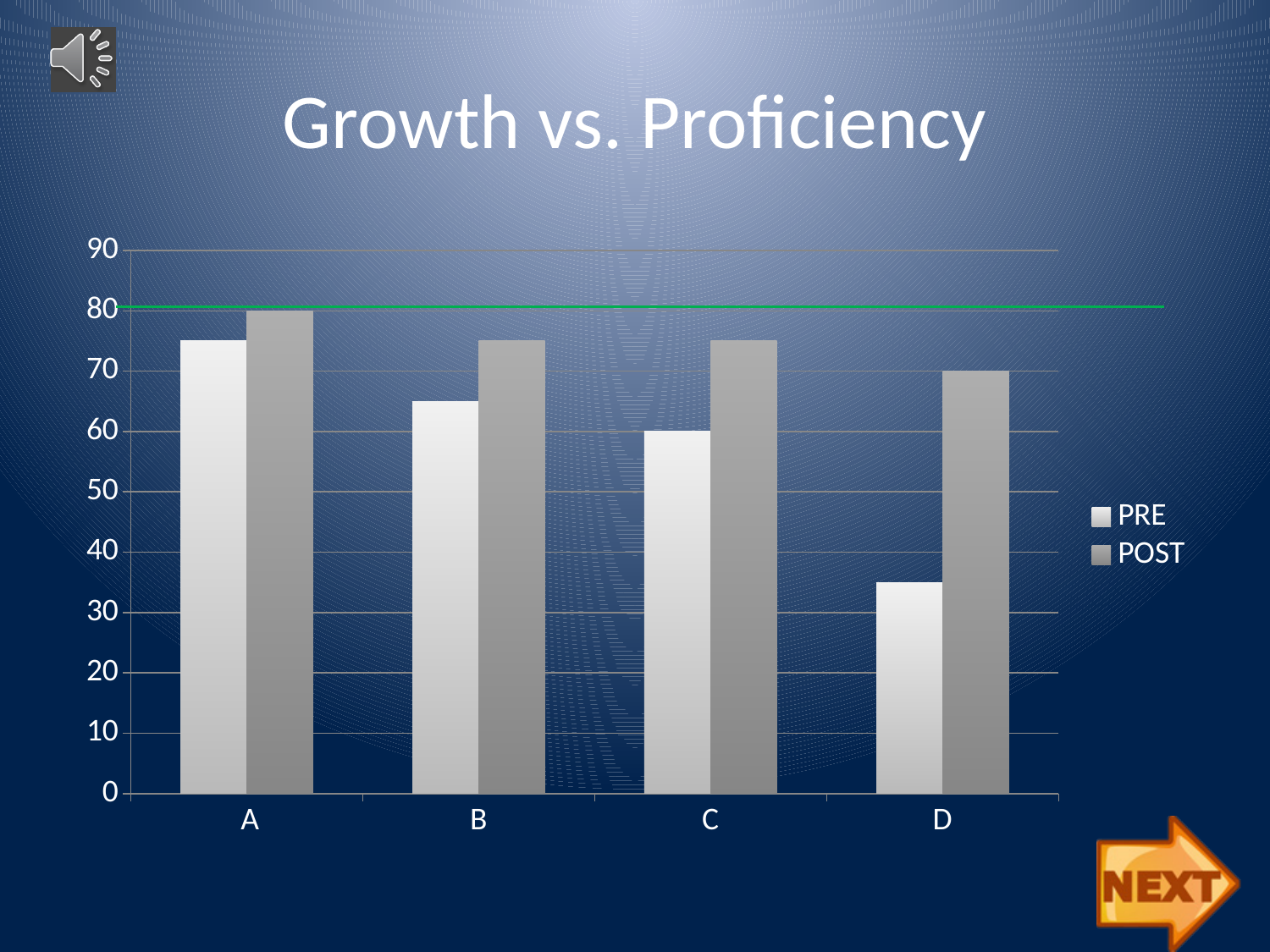
How many series does the legend list? 2 How many categories are shown on the x axis? 4 What kind of chart is shown on the slide? bar chart What is the title of the chart? Growth vs. Proficiency Do the PRE values rise or fall from A to D? fall Which category has the highest POST value? A Is the PRE value for B greater or less than 60? greater For category D, which is larger, the PRE value or the POST value? POST What are the two series named in the legend? PRE and POST Is the PRE value for D greater or less than 40? less Which category has the lowest PRE value? D Is the POST value for A greater or less than 70? greater